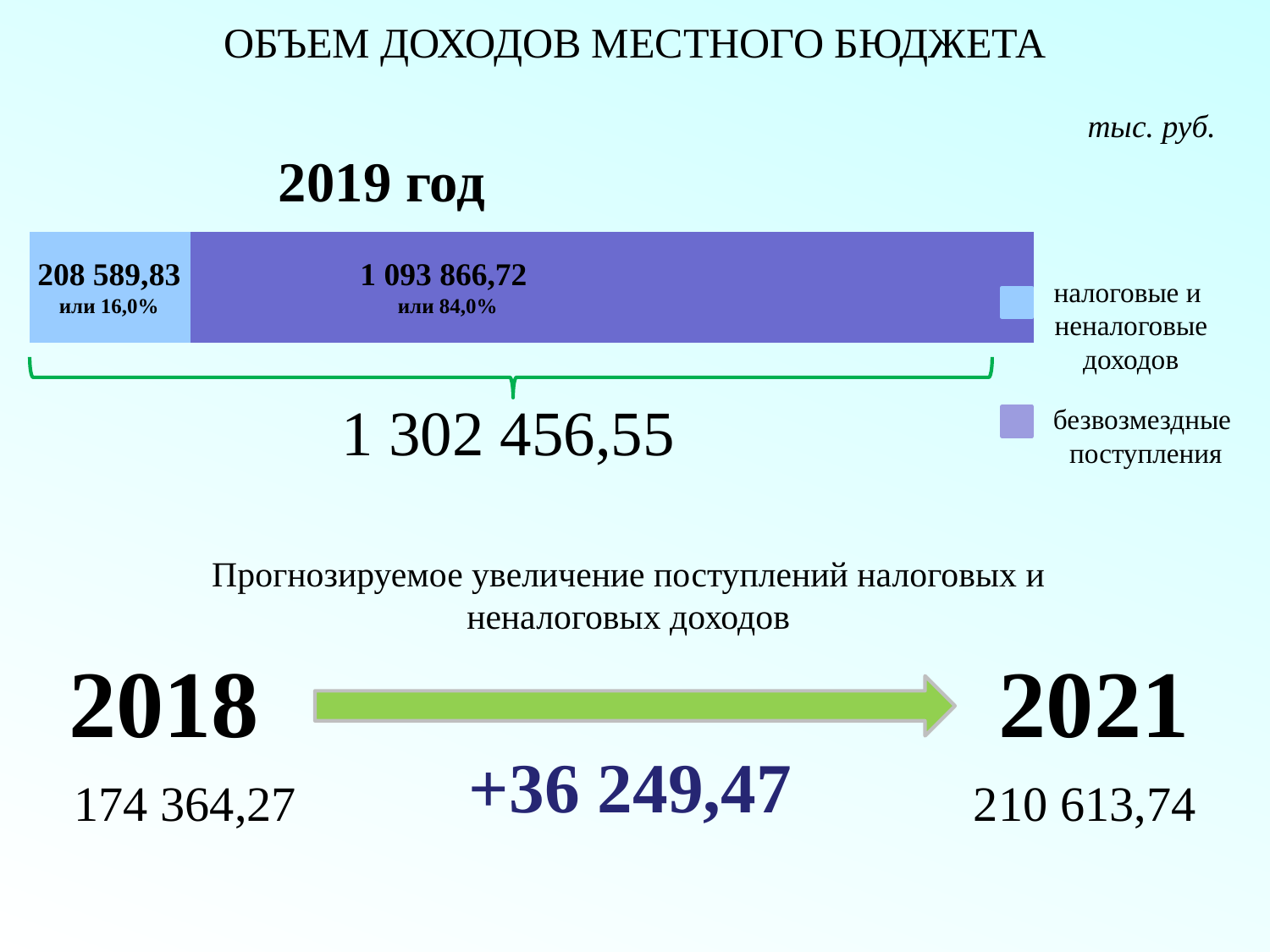
What is the value of налоговые и неналоговые доходы in the 2019 bar chart? 208 589,83 How many series does the legend of the 2019 bar chart list? 2 What share of the 2019 bar do налоговые и неналоговые доходы make up? 16,0% What is the difference between безвозмездные поступления and налоговые и неналоговые доходы in the 2019 bar? 885 276,89 Which segment of the 2019 bar is the smallest? налоговые и неналоговые доходы What kind of chart shows the 2019 budget revenue? stacked bar chart What unit is stated for the values on the slide? тыс. руб. In the lower diagram, what is the forecast increase in tax and non-tax revenue from 2018 to 2021? +36 249,47 What share of the 2019 bar do безвозмездные поступления make up? 84,0% Which segment of the 2019 bar is larger: налоговые и неналоговые доходы or безвозмездные поступления? безвозмездные поступления What is the value of безвозмездные поступления in the 2019 bar chart? 1 093 866,72 What is the total of the 2019 stacked bar? 1 302 456,55